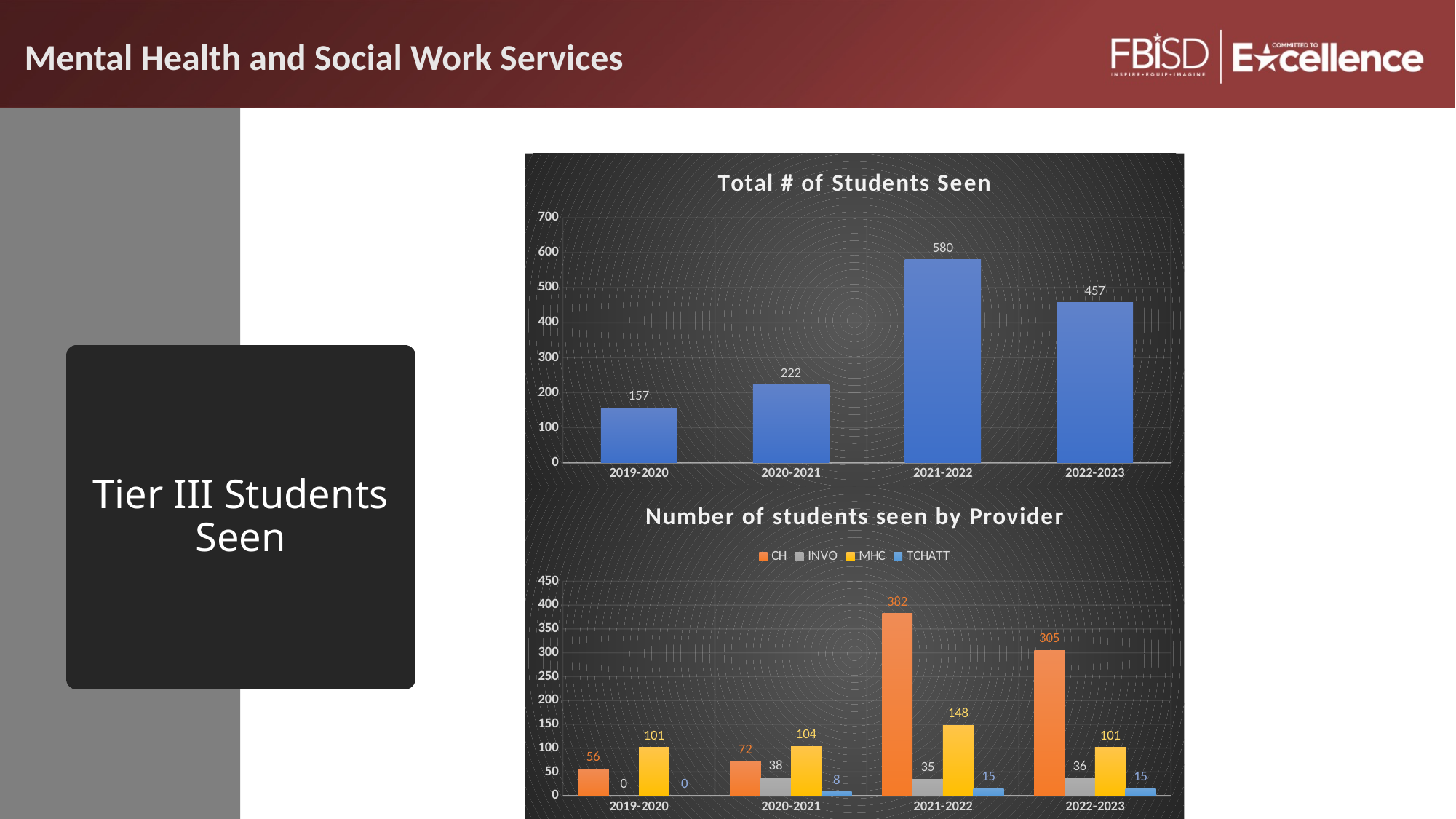
In the 'Number of students seen by Provider' chart, which is larger for 2019-2020: CH or MHC? MHC What kind of chart is the 'Total # of Students Seen' chart? Bar chart In the 'Number of students seen by Provider' chart, what is the CH value for 2021-2022? 382 In the 'Total # of Students Seen' chart, how many years are shown on the x axis? 4 In the 'Number of students seen by Provider' chart, how many series does the legend list? 4 In the 'Number of students seen by Provider' chart, what is the TCHATT value for 2019-2020? 0 In the 'Total # of Students Seen' chart, what is the value for 2021-2022? 580 In the 'Total # of Students Seen' chart, is the value for 2020-2021 greater or less than 200? greater In the 'Number of students seen by Provider' chart, what is the MHC value for 2020-2021? 104 In the 'Total # of Students Seen' chart, which year has the lowest value? 2019-2020 In the 'Number of students seen by Provider' chart, what is the difference between the CH values for 2021-2022 and 2022-2023? 77 In the 'Total # of Students Seen' chart, what is the difference between the 2021-2022 and 2022-2023 values? 123